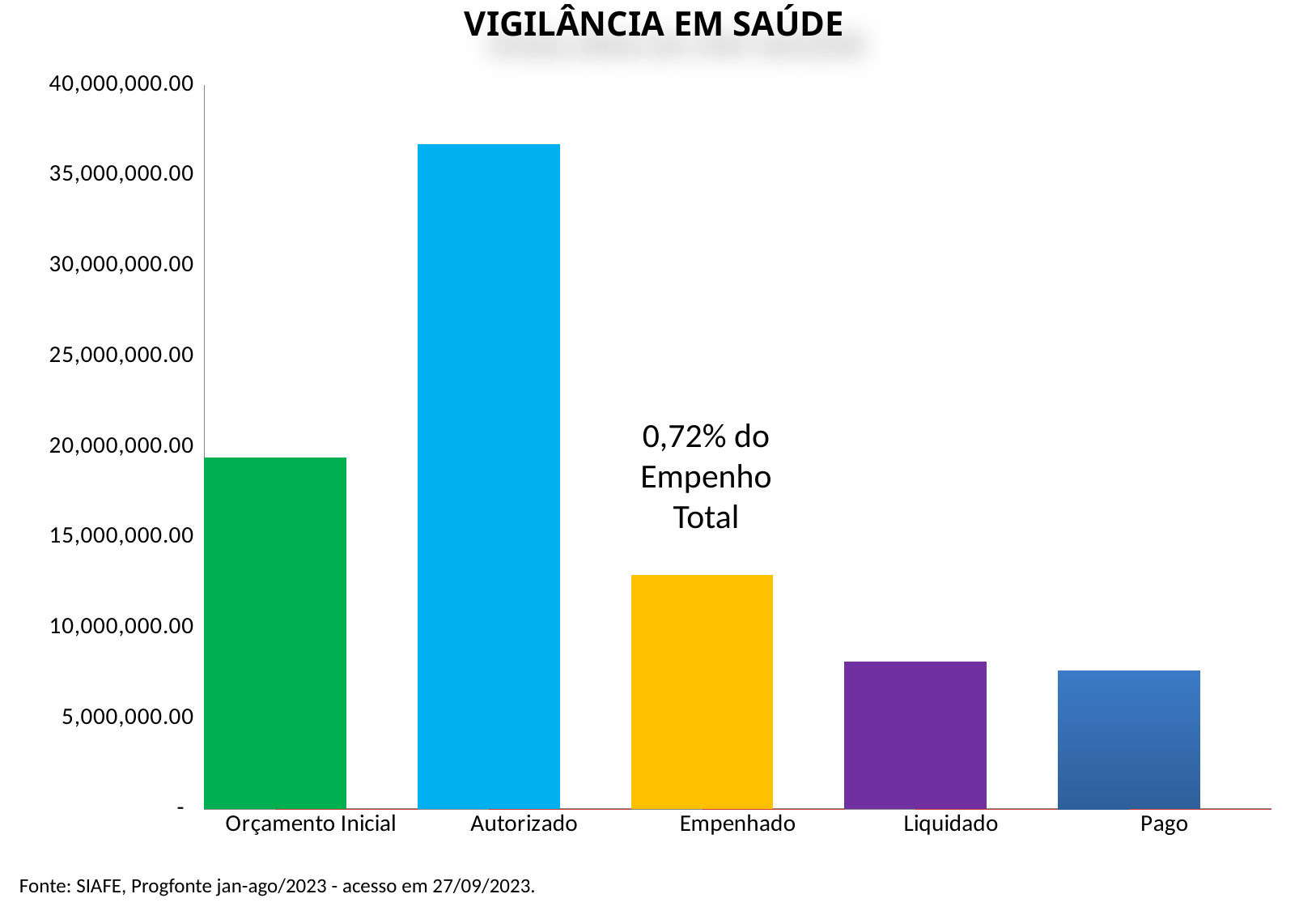
What is the title of the chart? VIGILÂNCIA EM SAÚDE Is the value for Empenhado greater or less than 10,000,000.00? greater Is the value for Pago greater or less than 5,000,000.00? greater What text annotation is printed above the Empenhado bar? 0,72% do Empenho Total Which is larger, the value for Autorizado or the value for Orçamento Inicial? Autorizado Is the value for Orçamento Inicial greater or less than 20,000,000.00? less Which is larger, the value for Orçamento Inicial or the value for Empenhado? Orçamento Inicial What kind of chart is shown on the slide? bar chart How many categories are shown on the x axis of the chart? 5 Which category has the highest value in the chart? Autorizado